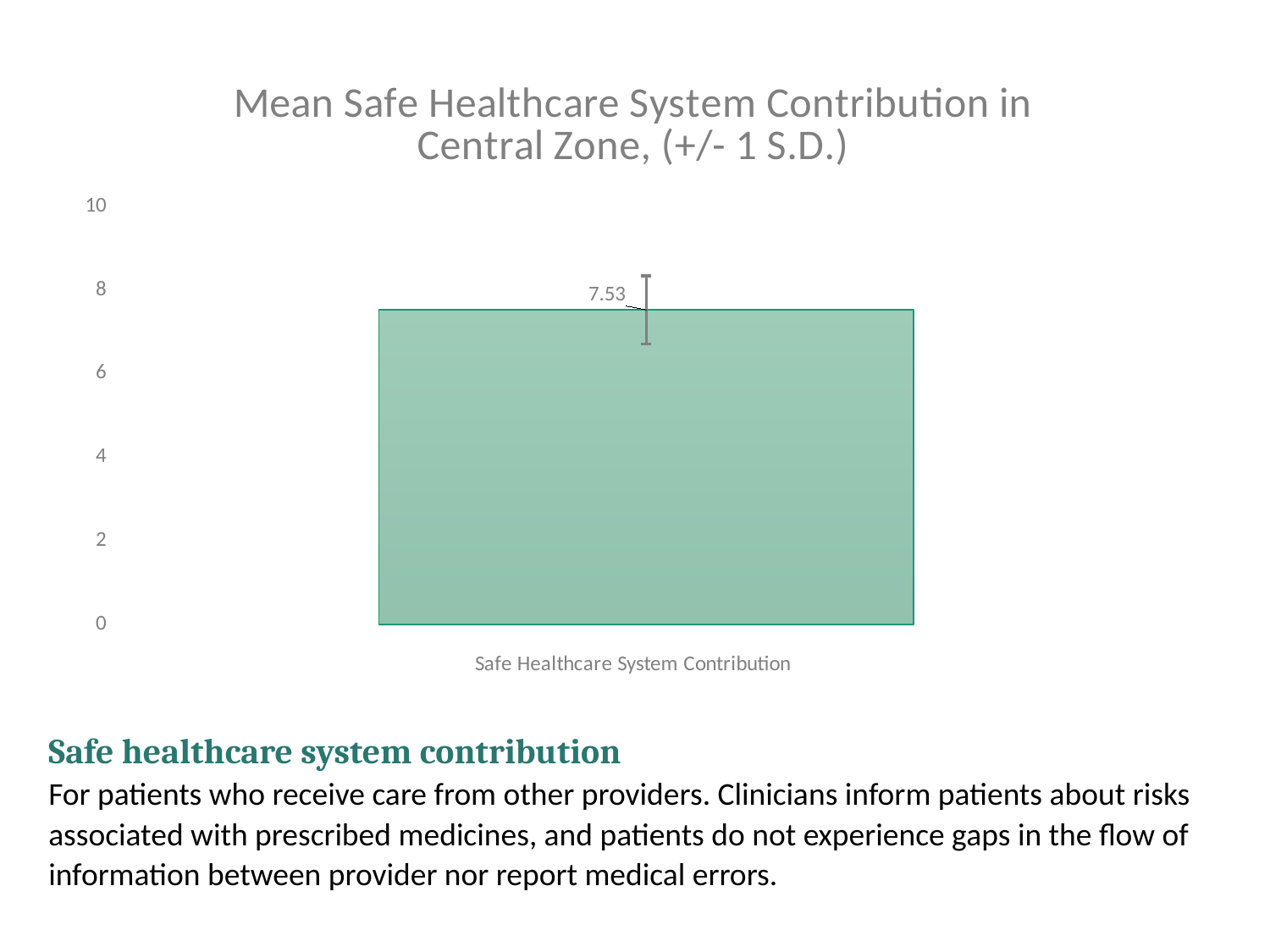
What is the title of the chart? Mean Safe Healthcare System Contribution in Central Zone, (+/- 1 S.D.) What kind of chart is shown on the slide? bar chart Is the value for Safe Healthcare System Contribution greater or less than 6? greater What is the category label shown beneath the bar? Safe Healthcare System Contribution How many bars are plotted in the chart? 1 What is the maximum value shown on the vertical axis? 10 What is the value shown for Safe Healthcare System Contribution? 7.53 Is the value for Safe Healthcare System Contribution greater or less than 8? less